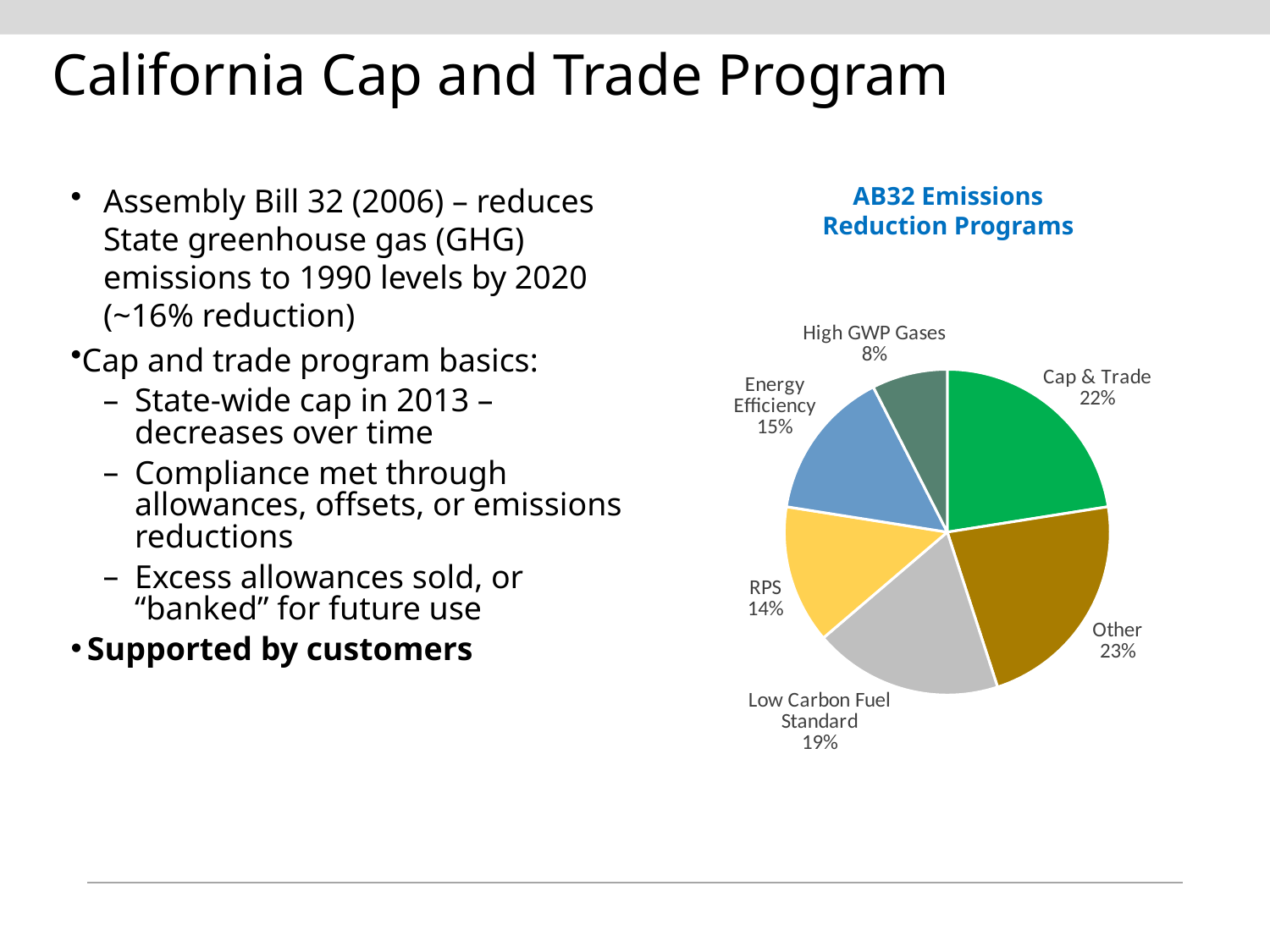
What is the difference in percentage points between Other and RPS? 9 What share of the pie does Cap & Trade represent? 22% How many categories are shown in the pie chart? 6 Which is larger, Cap & Trade or Low Carbon Fuel Standard? Cap & Trade What is the title of the chart? AB32 Emissions Reduction Programs What kind of chart is shown on the slide? Pie chart Which category has the largest slice of the pie? Other What percentage is shown for Low Carbon Fuel Standard? 19% Which category has the smallest slice of the pie? High GWP Gases What is the combined share of RPS and Energy Efficiency? 29% What is the value for Energy Efficiency? 15% What colour is the Cap & Trade slice? Green